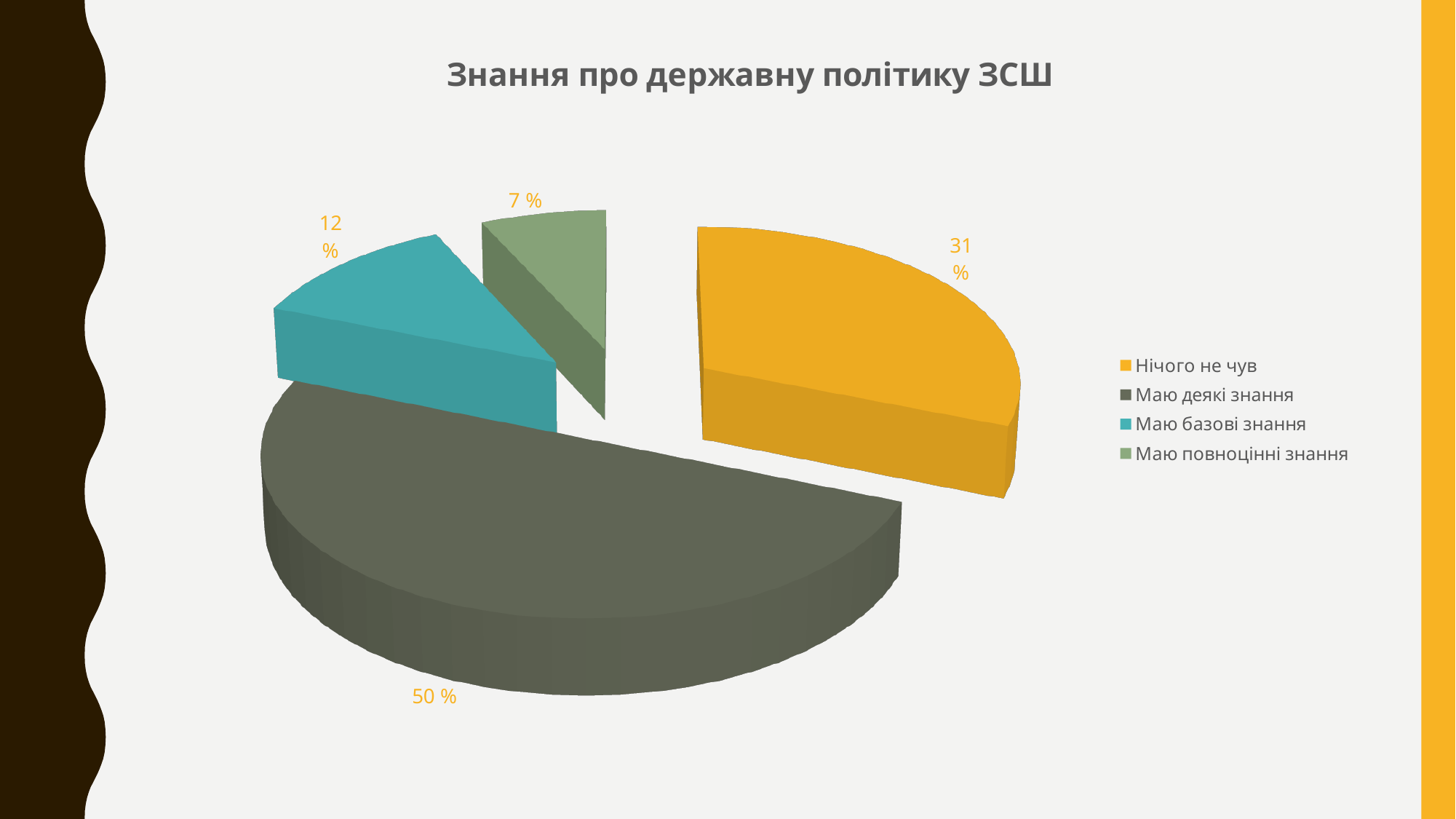
What kind of chart is shown on the slide? Pie chart Which category has the largest slice of the pie? Маю деякі знання What share of the pie is labelled for "Маю повноцінні знання"? 7 % What share of the pie is labelled for "Нічого не чув"? 31 % What share of the pie is labelled for "Маю базові знання"? 12 % What is the title of the chart? Знання про державну політику ЗСШ What share of the pie is labelled for "Маю деякі знання"? 50 % How many categories does the legend list? 4 Which is larger: the slice for "Маю базові знання" or the slice for "Маю повноцінні знання"? Маю базові знання What is the difference in percentage points between "Маю деякі знання" and "Нічого не чув"? 19 What colour is the slice for "Нічого не чув"? Yellow Which category has the smallest slice of the pie? Маю повноцінні знання